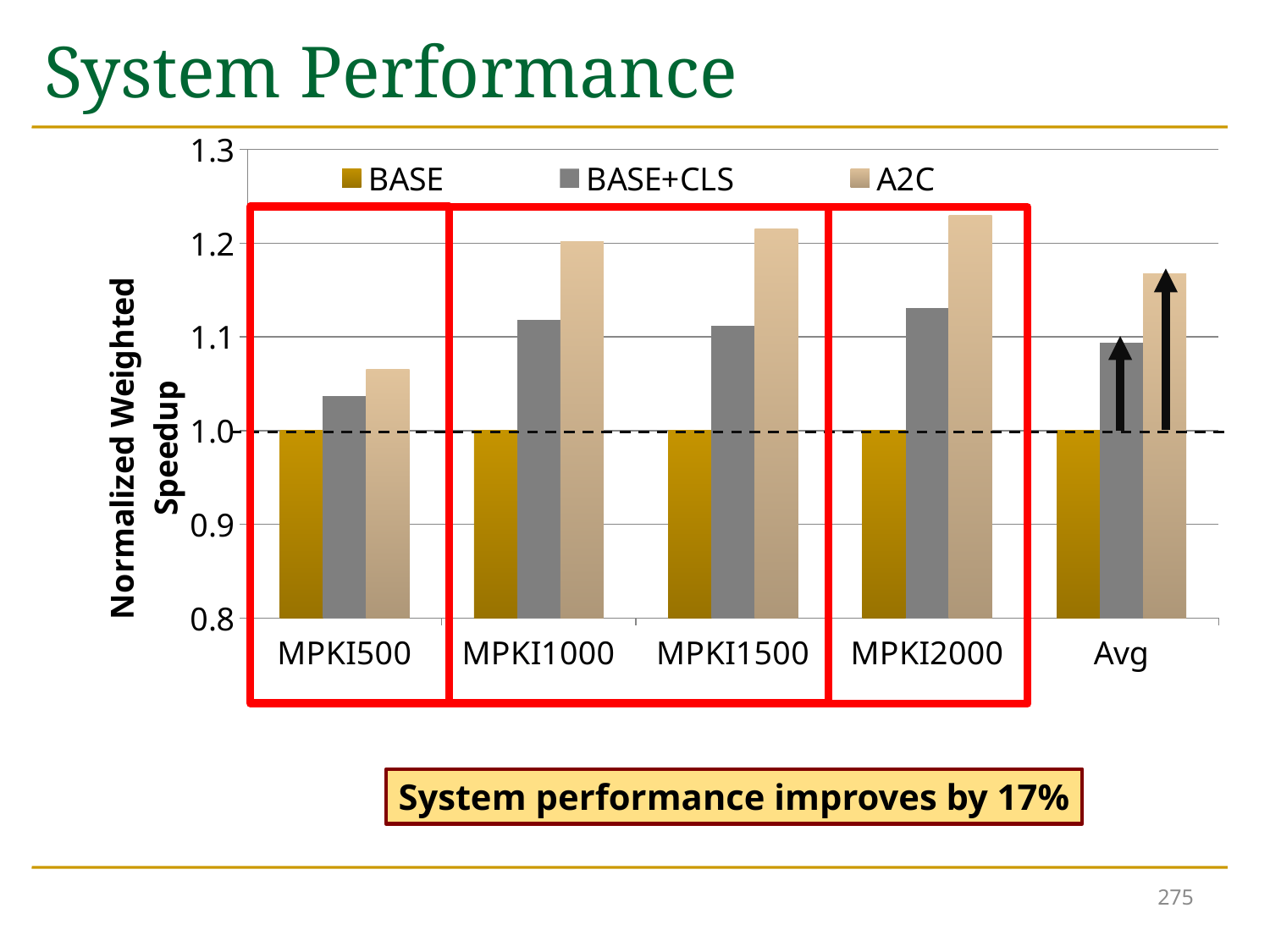
What kind of chart is shown on the slide? bar chart For MPKI1000, which is larger: BASE+CLS or A2C? A2C What is the label of the y axis? Normalized Weighted Speedup Do the A2C values rise or fall from MPKI500 to MPKI2000? rise Is the value of BASE+CLS for MPKI500 greater or less than 1.1? less Which category has the lowest A2C value? MPKI500 What is the value of BASE for MPKI500? 1.0 Is the value of A2C for Avg greater or less than 1.1? greater Is the value of A2C for MPKI500 greater or less than 1.1? less How many series does the legend list? 3 How many categories are shown on the x axis? 5